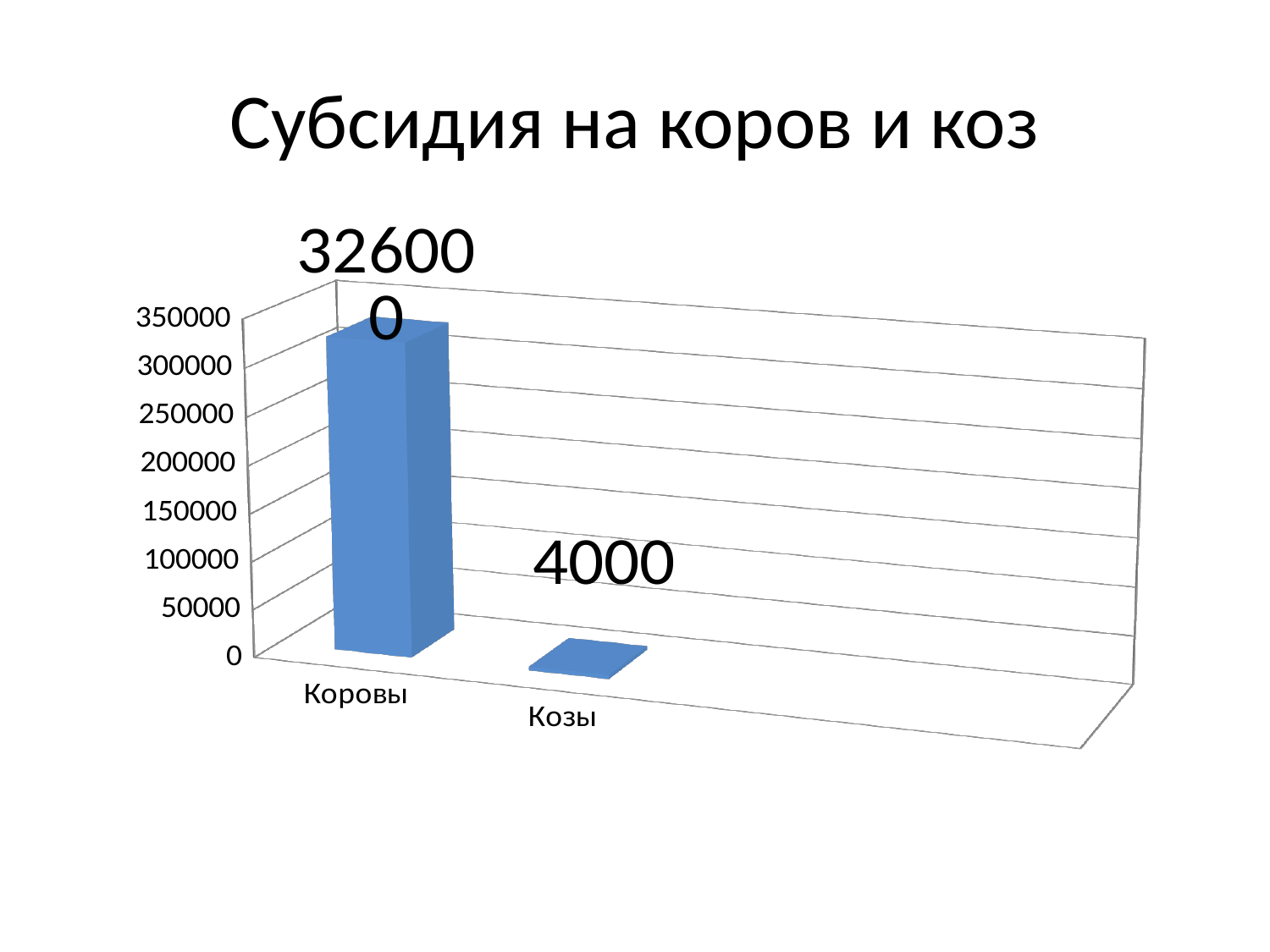
What kind of chart is shown on the slide? bar chart Is the value for Коровы greater or less than 300000? greater Which is larger, the value for Коровы or the value for Козы? Коровы What is the difference between the values for Коровы and Козы? 322000 Is the value for Козы greater or less than 50000? less How many categories are shown on the chart? 2 What is the value for Козы? 4000 Which category has the lowest value? Козы What is the value for Коровы? 326000 What is the title of the chart? Субсидия на коров и коз Which category has the highest value? Коровы What is the highest value shown on the vertical axis? 350000